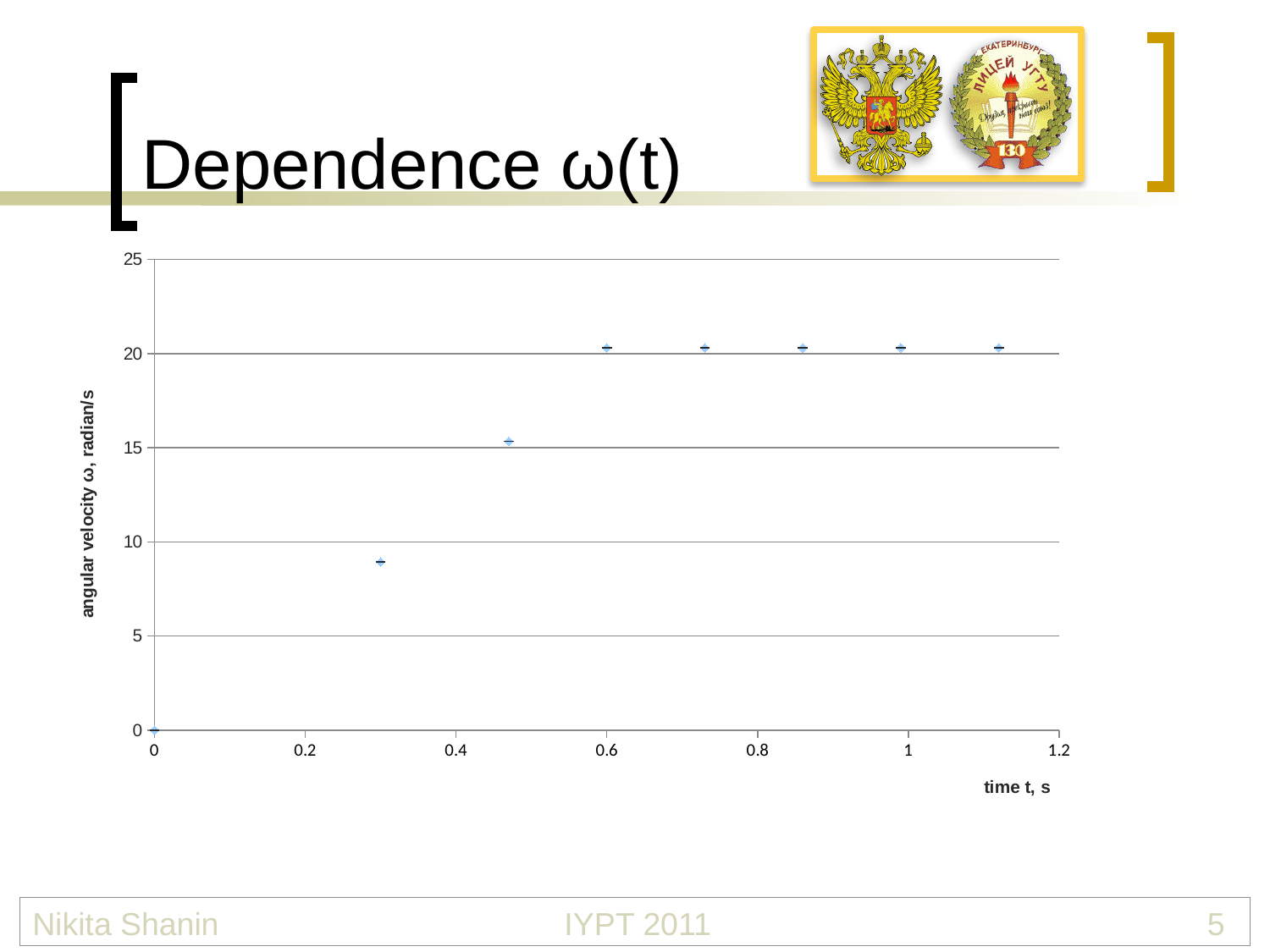
Which is larger: the angular velocity at t = 0.3 s or at t ≈ 0.47 s? t ≈ 0.47 s Is the angular velocity at t = 0.3 s greater or less than 5 radian/s? greater What is the highest value shown on the vertical axis? 25 What kind of chart is shown on the slide? scatter chart Is the angular velocity at t ≈ 1.12 s greater or less than 25 radian/s? less What is the title of the chart on the slide? Dependence ω(t) What is the label of the vertical axis? angular velocity ω, radian/s Is the angular velocity at t = 0.3 s greater or less than 10 radian/s? less How does the angular velocity change as time increases along the x axis? rises, then levels off